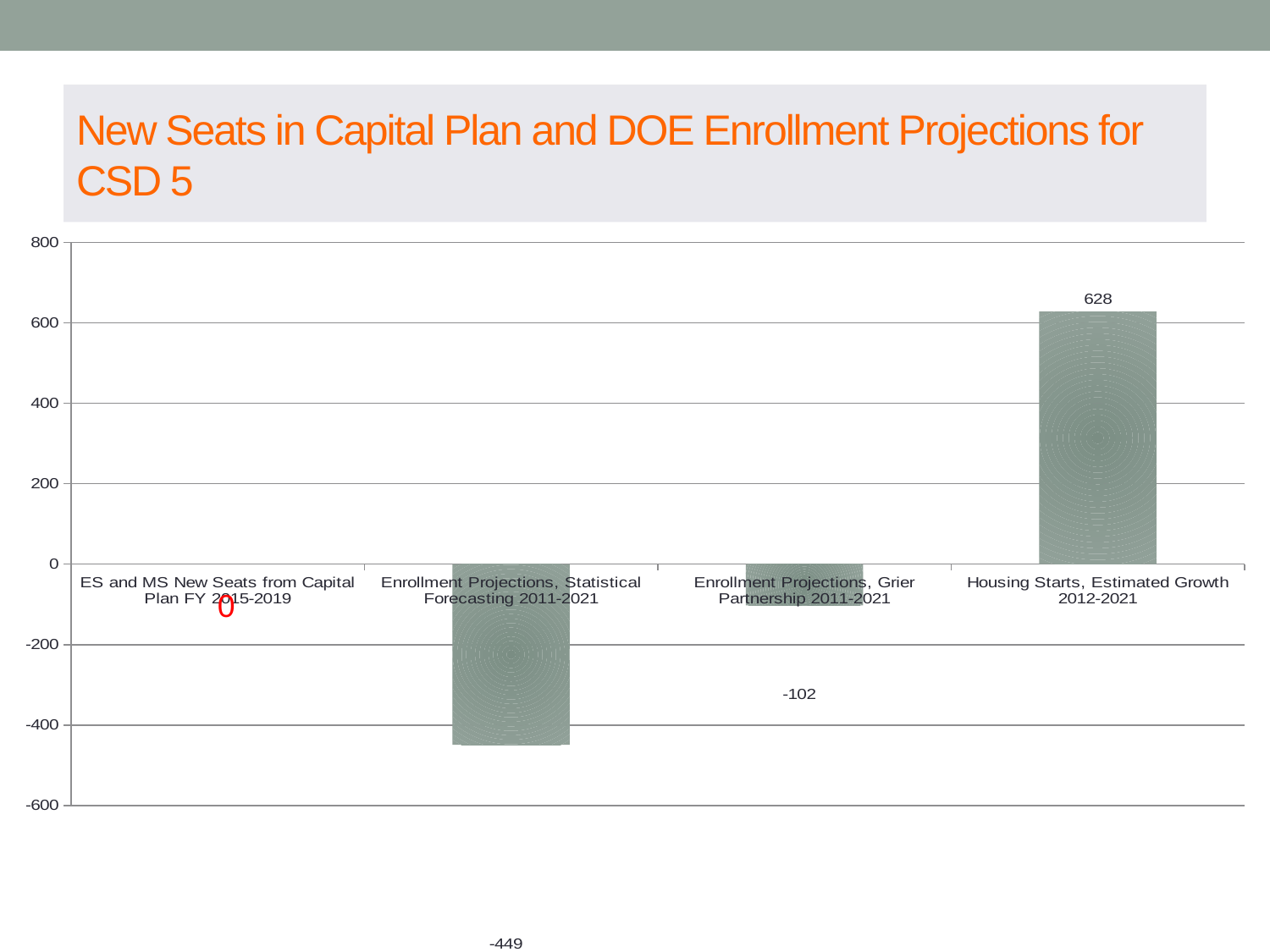
How many categories are shown in the chart? 4 Which is larger, the value for Enrollment Projections, Grier Partnership 2011-2021 or the value for Enrollment Projections, Statistical Forecasting 2011-2021? Enrollment Projections, Grier Partnership 2011-2021 What is the value for Enrollment Projections, Statistical Forecasting 2011-2021? -449 What is the value for Enrollment Projections, Grier Partnership 2011-2021? -102 What is the title of the slide? New Seats in Capital Plan and DOE Enrollment Projections for CSD 5 What is the value for ES and MS New Seats from Capital Plan FY 2015-2019? 0 What is the value for Housing Starts, Estimated Growth 2012-2021? 628 Which category has the lowest value? Enrollment Projections, Statistical Forecasting 2011-2021 What is the difference between the value for Housing Starts, Estimated Growth 2012-2021 and the value for Enrollment Projections, Grier Partnership 2011-2021? 730 What kind of chart is shown on the slide? bar chart Is the value for Housing Starts, Estimated Growth 2012-2021 greater or less than 600? greater Which category has the highest value? Housing Starts, Estimated Growth 2012-2021